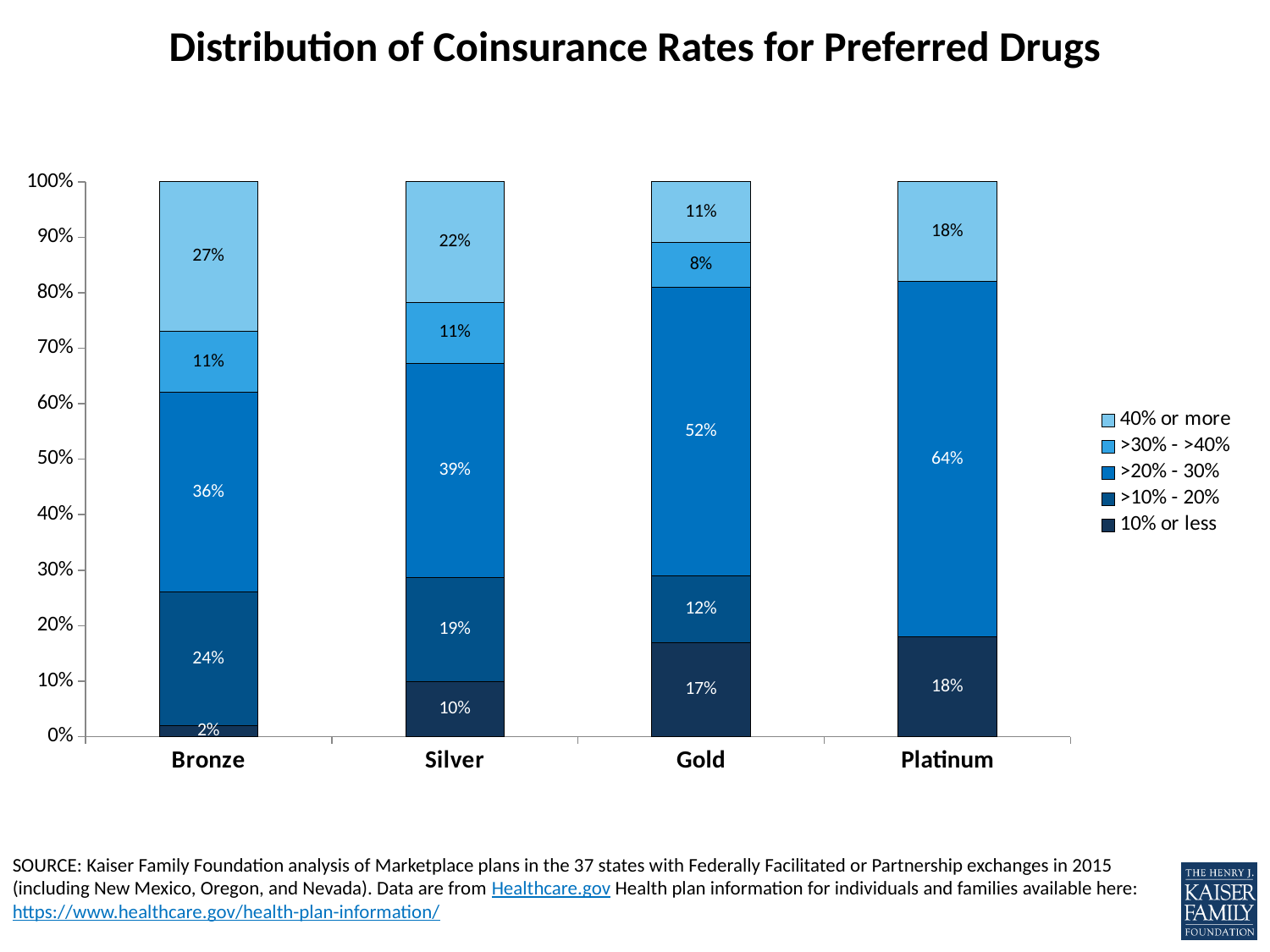
What is the title of the chart? Distribution of Coinsurance Rates for Preferred Drugs What share of Platinum plans have a coinsurance rate of >20% - 30%? 64% Which metal tier has the smallest share of plans with coinsurance of 10% or less? Bronze What share of Gold plans have a coinsurance rate of 10% or less? 17% What share of Bronze plans have a coinsurance rate of 40% or more for preferred drugs? 27% How many series does the legend list? 5 What is the difference between the Gold and Bronze shares for the >20% - 30% coinsurance range? 16 percentage points Which metal tier has the largest share of plans in the >20% - 30% coinsurance range? Platinum How many metal tiers (categories) are shown on the x axis? 4 What type of chart is shown on the slide? Stacked bar chart What share of Silver plans have a coinsurance rate of >10% - 20%? 19% Which is larger: the share of Silver plans with coinsurance of 40% or more, or the share of Gold plans with coinsurance of 40% or more? Silver